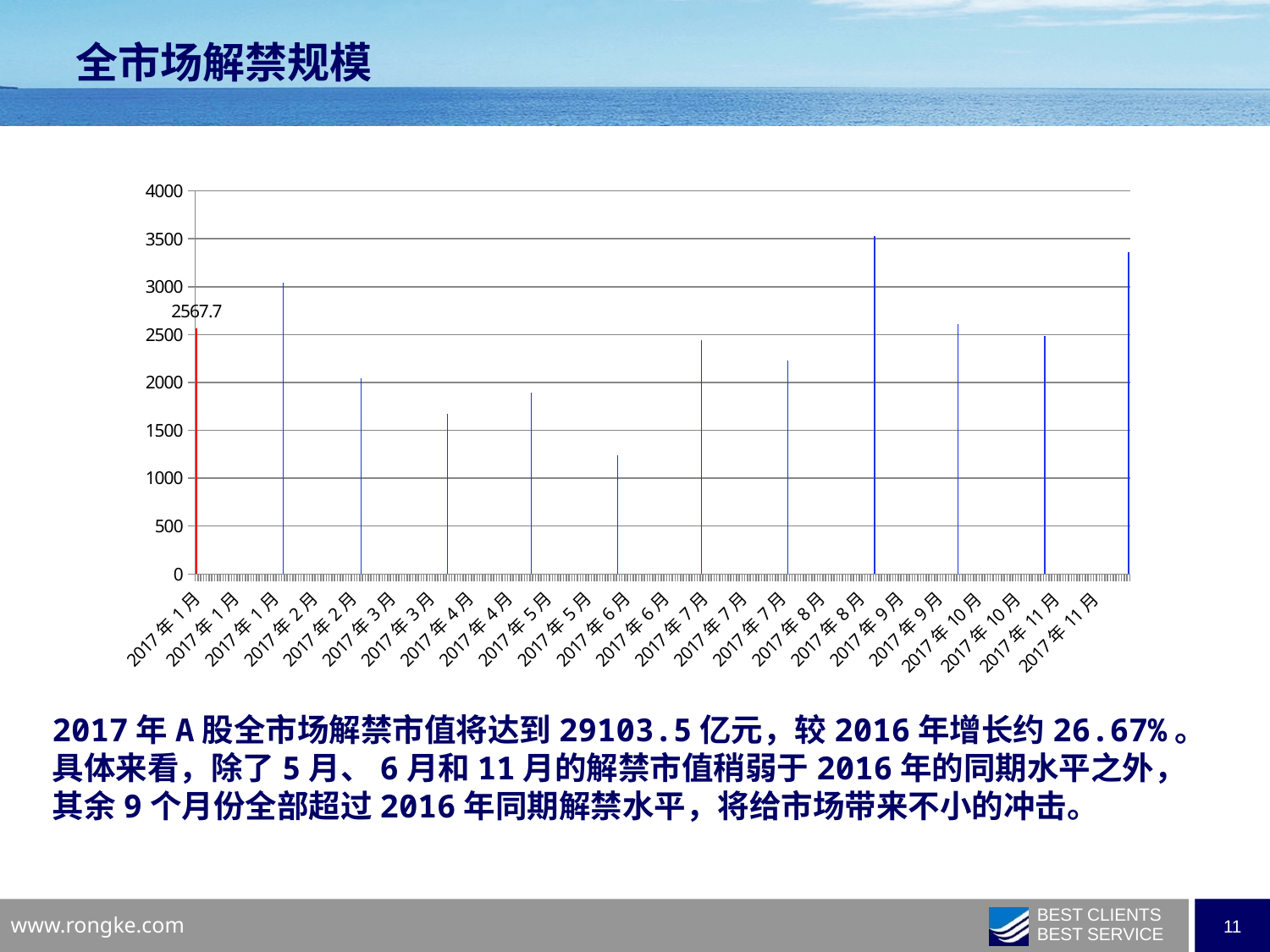
Is the value of the first (red) bar greater or less than 2500? greater Which is larger, the first (red) bar or the second bar? the second bar What is the title of the slide containing the chart? 全市场解禁规模 Is the value of the first (red) bar greater or less than 3000? less Is the tallest bar in the chart greater or less than 3000? greater What colour is the first bar in the chart? red What kind of chart is shown on the slide? bar chart What is the maximum value shown on the y axis of the chart? 4000 How many bars are plotted in the chart? 12 What is the data label shown on the first (red) bar of the chart? 2567.7